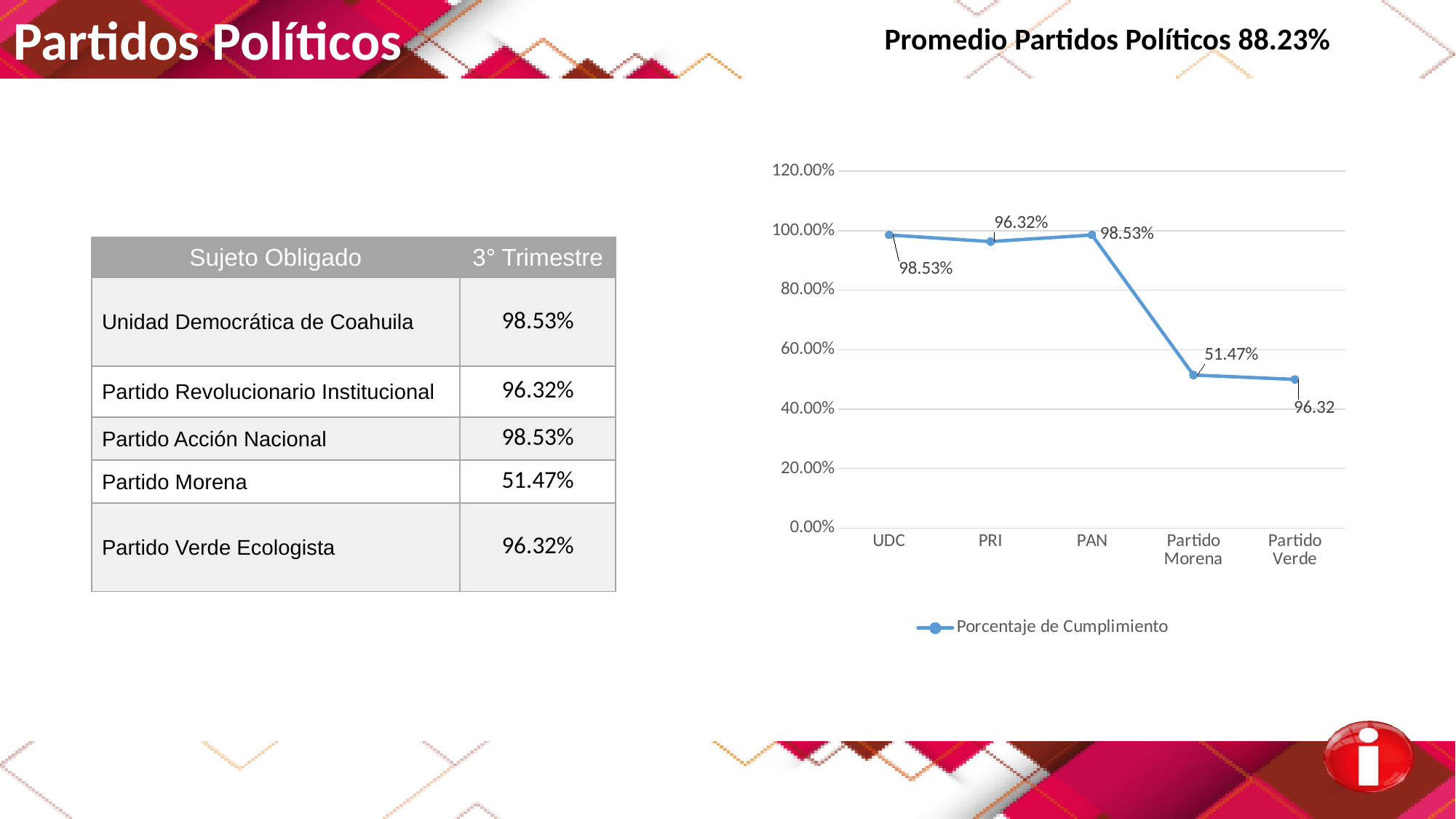
What is the name of the series shown in the chart legend? Porcentaje de Cumplimiento What is the difference between the values for UDC and PRI? 2.21% What is the value for UDC in the chart? 98.53% What kind of chart is shown on the slide? line chart What is the value for PAN in the chart? 98.53% What is the value for Partido Morena in the chart? 51.47% How many series does the chart legend list? 1 Which has a larger value, PRI or Partido Morena? PRI What is the difference between the values for PAN and Partido Morena? 47.06% What is the value for PRI in the chart? 96.32% How many categories are shown on the x axis of the chart? 5 Is the value for Partido Morena greater or less than 60.00%? less